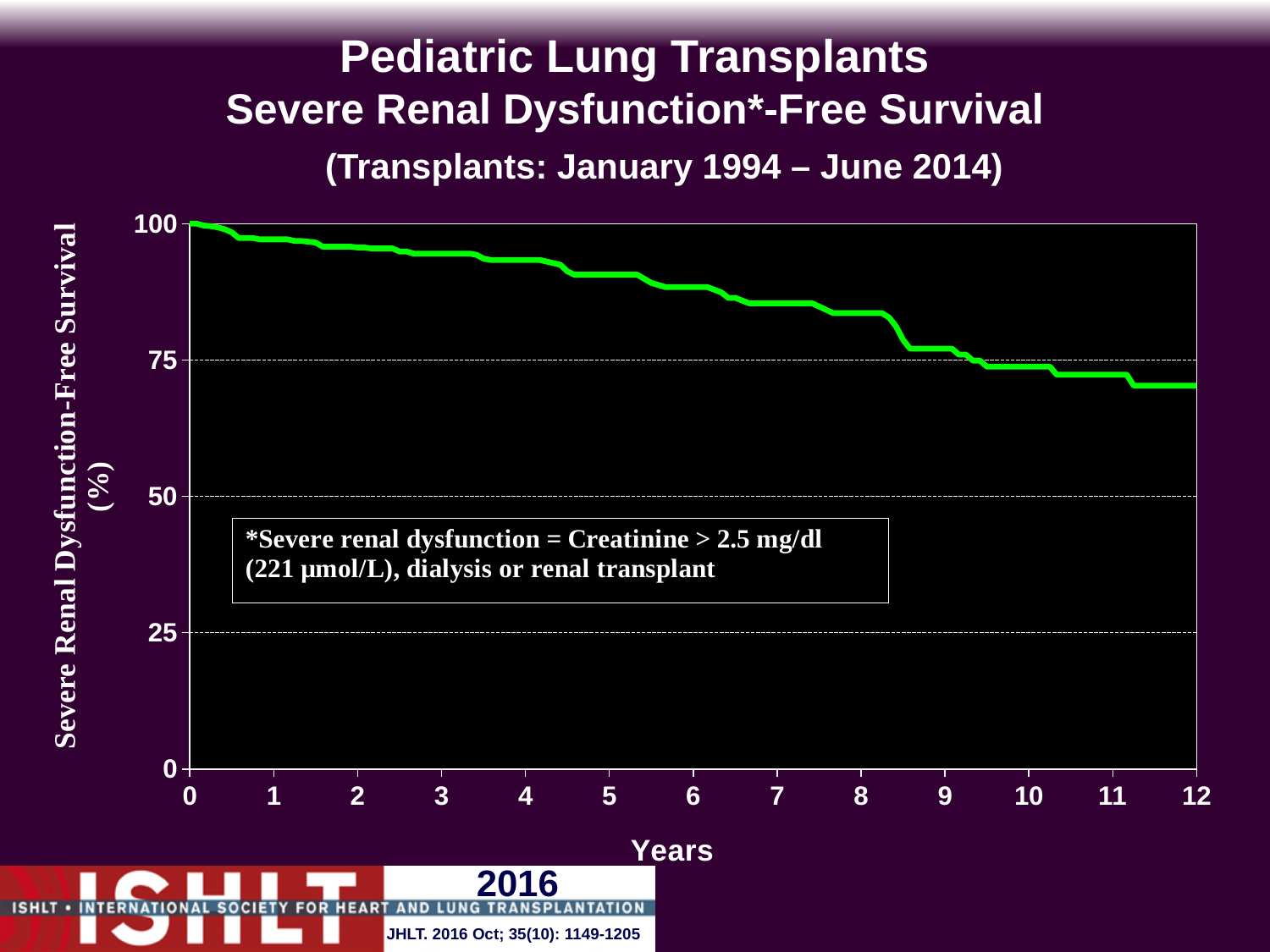
Is the survival value at year 12 greater or less than 50? greater Is the survival value at year 8 greater or less than 75? greater Is the survival value at year 5 greater or less than 75? greater How many year tick marks are labelled on the x axis? 13 What kind of chart is shown on the slide? line chart Which is larger, the survival value at year 2 or at year 10? year 2 What is the severe renal dysfunction-free survival value at year 0? 100 What colour is the survival line on the chart? green Does the severe renal dysfunction-free survival rise or fall as the years increase? fall What is the label of the x axis? Years